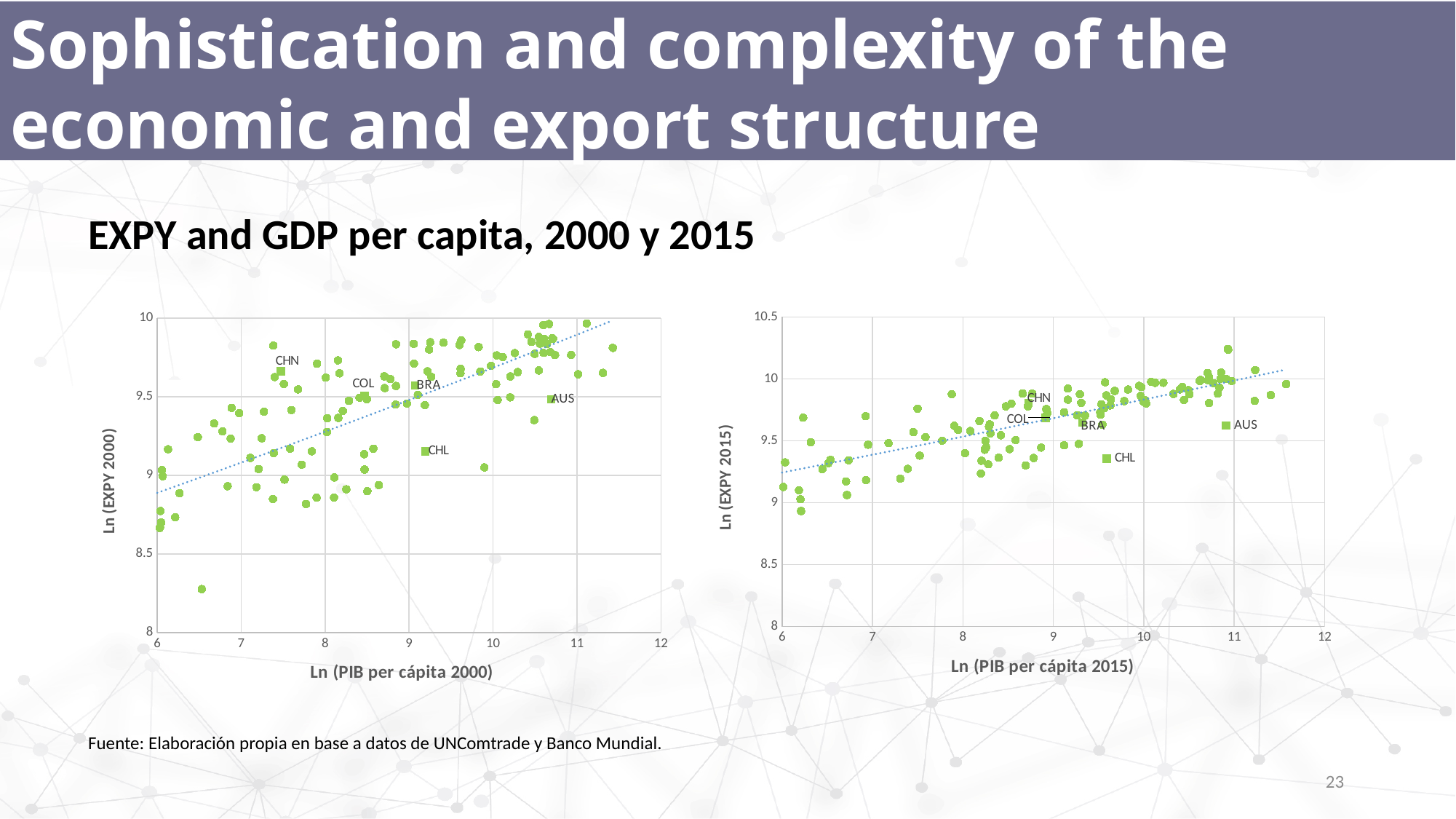
What kind of chart is the left chart (EXPY 2000 vs GDP per capita 2000)? Scatter chart In the right chart (EXPY 2015), which labeled country has the higher Ln (EXPY 2015) value, AUS or CHL? AUS In the left chart (EXPY 2000), is the Ln (EXPY 2000) value for CHL greater or less than 9.5? less What is the x-axis title of the left chart? Ln (PIB per cápita 2000) In the left chart (EXPY 2000), which labeled country has the lowest Ln (EXPY 2000) value? CHL In the right chart (EXPY 2015), do the values of Ln (EXPY 2015) generally rise or fall as Ln (PIB per cápita 2015) increases? Rise In the right chart (EXPY 2015), is the Ln (EXPY 2015) value for CHL greater or less than 9.5? less In the left chart (EXPY 2000), which labeled country has the higher Ln (EXPY 2000) value, CHN or CHL? CHN How many countries are labeled by name in the right chart (EXPY 2015)? 5 What is the y-axis title of the right chart? Ln (EXPY 2015) In the left chart (EXPY 2000), is the Ln (EXPY 2000) value for CHN greater or less than 9.5? greater